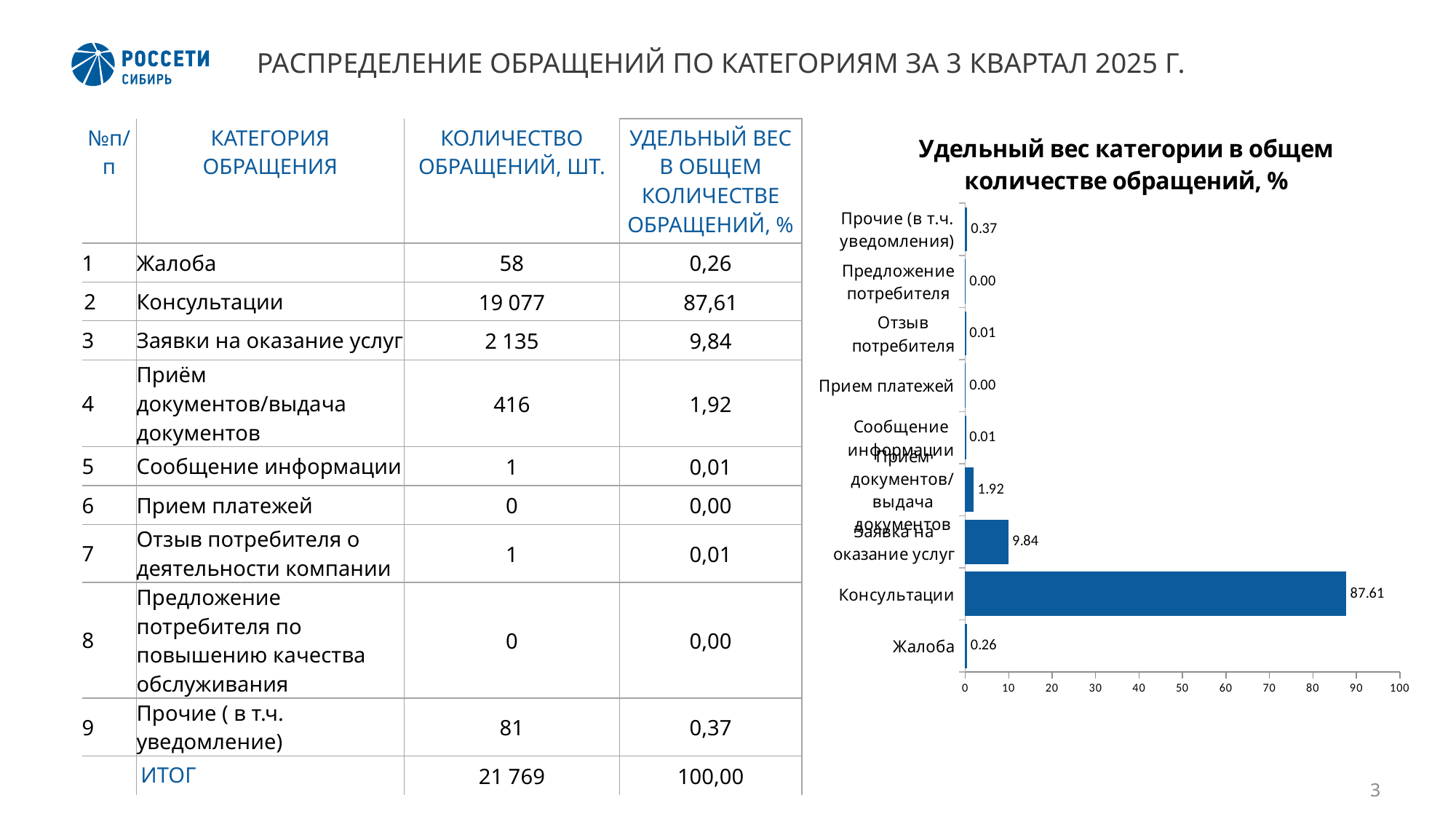
What is the title of the chart on the slide? Удельный вес категории в общем количестве обращений, % Which category has the highest value in the chart? Консультации What is the value shown for Консультации in the chart? 87.61 What is the value shown for Прочие (в т.ч. уведомления) in the chart? 0.37 How many categories are plotted in the chart? 9 What is the value shown for Приём документов/выдача документов in the chart? 1.92 What is the difference between the values for Консультации and Заявка на оказание услуг in the chart? 77.77 Is the value for Консультации in the chart greater or less than 80? greater What is the value shown for Жалоба in the chart? 0.26 What is the value shown for Заявка на оказание услуг in the chart? 9.84 Which is larger in the chart: the value for Жалоба or the value for Прочие (в т.ч. уведомления)? Прочие (в т.ч. уведомления) What type of chart is shown on the slide? bar chart